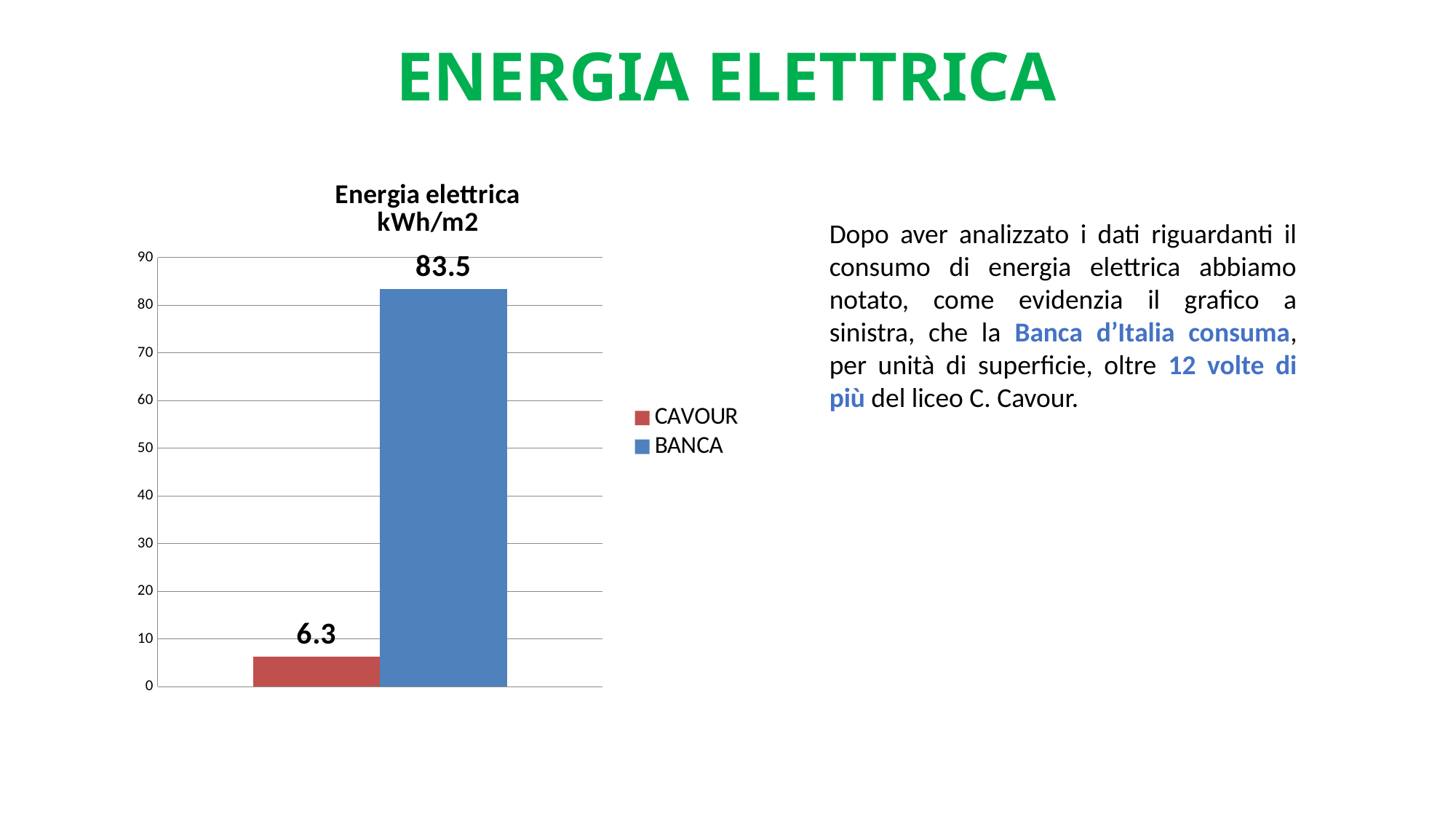
What kind of chart is shown on the slide? bar chart What is the value for BANCA in the Energia elettrica kWh/m2 chart? 83.5 What is the value for CAVOUR in the Energia elettrica kWh/m2 chart? 6.3 Is the value for BANCA greater or less than 80? greater What is the title of the chart? Energia elettrica kWh/m2 Which series has the highest value in the chart? BANCA What colour is the BANCA bar? blue Is the value for CAVOUR greater or less than 10? less What is the difference between the BANCA and CAVOUR values? 77.2 Which is larger, the value for CAVOUR or the value for BANCA? BANCA Which series has the lowest value in the chart? CAVOUR How many series does the legend list? 2